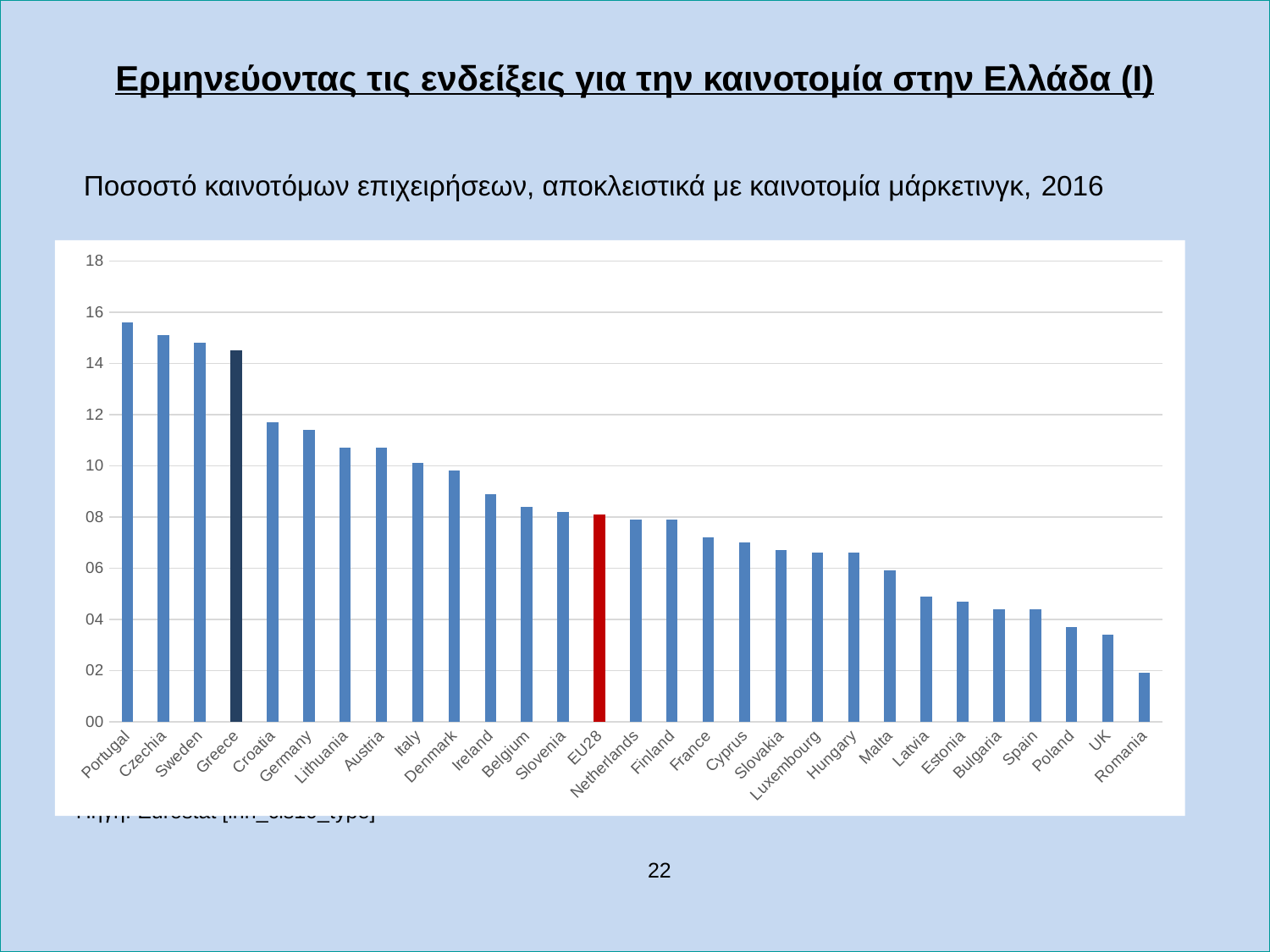
Is the value for Greece greater or less than 14? greater How many bars are plotted in the chart? 29 What type of chart is shown on the slide? Bar chart Do the bar values rise or fall moving from left to right along the x axis? Fall Which country has the highest bar in the chart? Portugal Which country has the lowest bar in the chart? Romania Which bar in the chart is coloured red? EU28 Is the value for EU28 greater or less than 10? less Is the value for Croatia greater or less than 10? greater Which is larger, the value for Greece or the value for Germany? Greece Which is larger, the value for Poland or the value for Malta? Malta